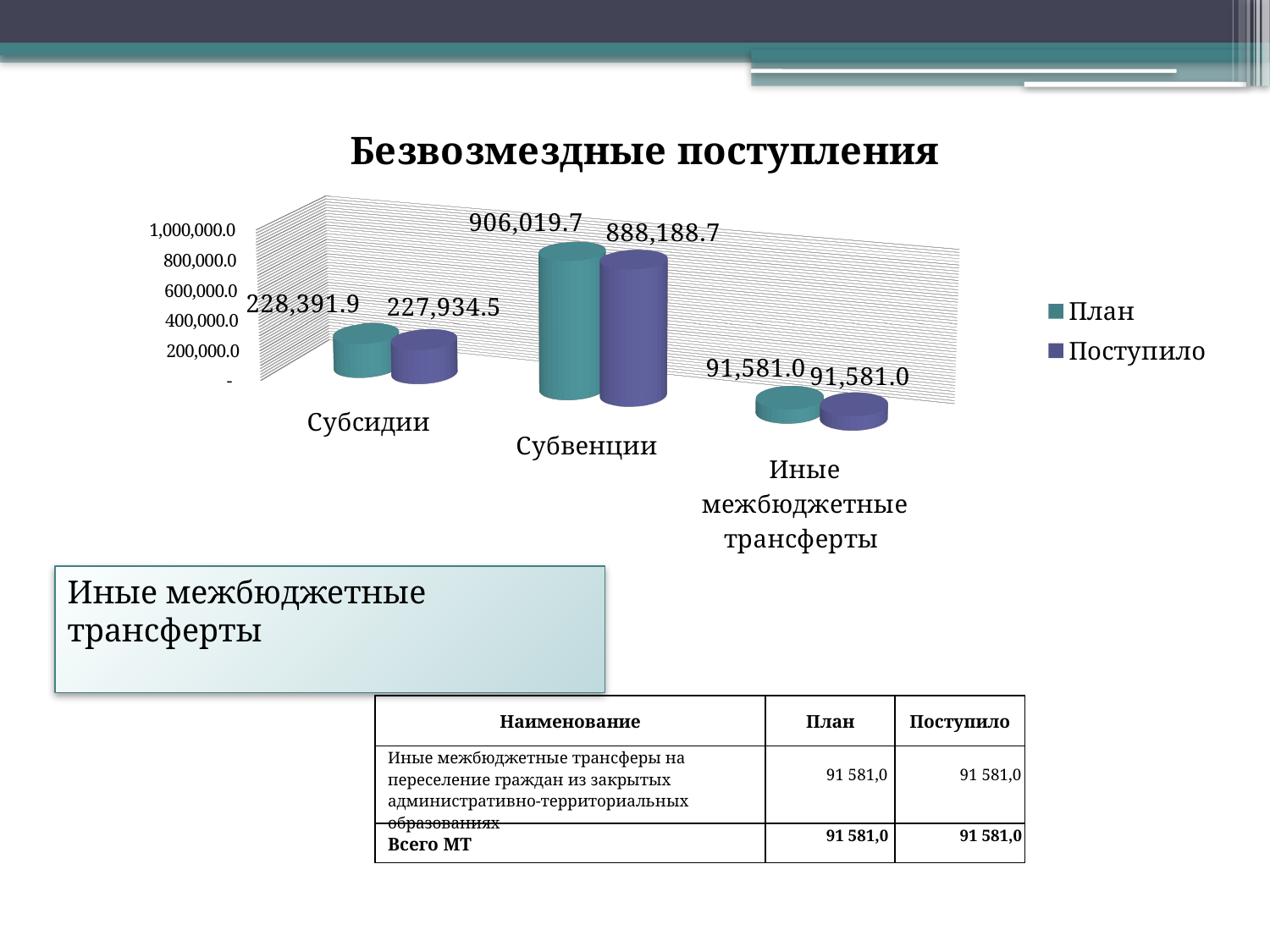
How many series does the chart legend list? 2 What is the difference between the План and Поступило values for Субвенции? 17,831.0 What is the Поступило value for Субсидии? 227,934.5 What is the Поступило value for Иные межбюджетные трансферты? 91,581.0 How many categories are shown on the x axis of the chart? 3 What kind of chart is shown on the slide? bar chart Is the Поступило value for Субвенции greater or less than 800,000.0? greater What is the title of the chart? Безвозмездные поступления Which category has the highest План value? Субвенции Which is larger: the План value for Субсидии or the План value for Иные межбюджетные трансферты? План value for Субсидии Which category has the lowest Поступило value? Иные межбюджетные трансферты What is the План value for Субвенции? 906,019.7